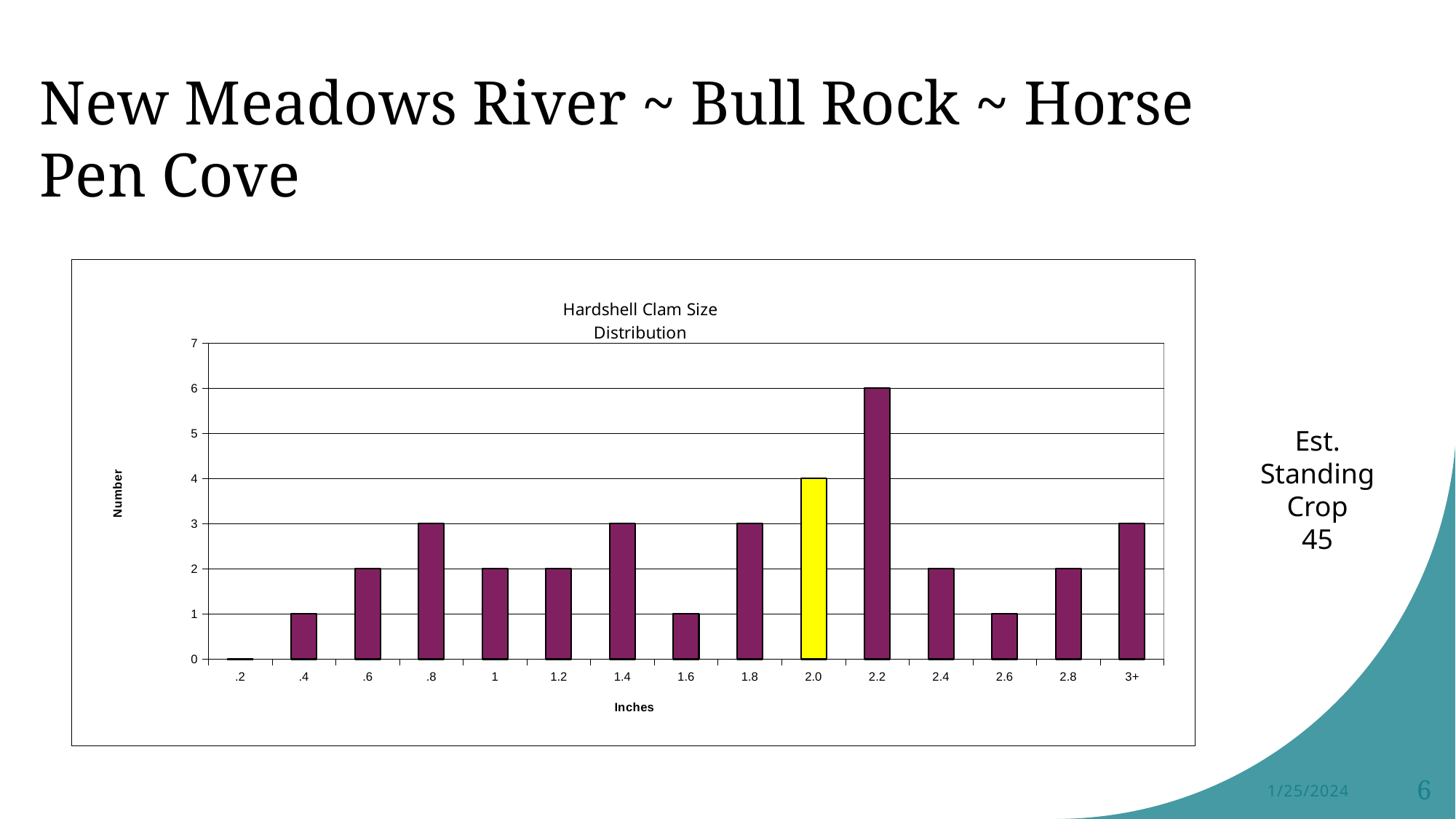
What kind of chart is shown on the slide? bar chart What is the number of clams in the 2.0 inch category? 4 Which has more clams, the 1.6 inch category or the 1.8 inch category? 1.8 What is the difference between the number of clams at 2.2 inches and at 2.0 inches? 2 What is the number of clams in the .8 inch category? 3 What is the title of the chart? Hardshell Clam Size Distribution What is the number of clams in the 2.2 inch category? 6 What is the number of clams in the 3+ inch category? 3 Which size category has the highest number of clams? 2.2 What is the label of the y axis? Number Which size category is shown with a yellow bar? 2.0 How many size categories are shown on the x axis? 15